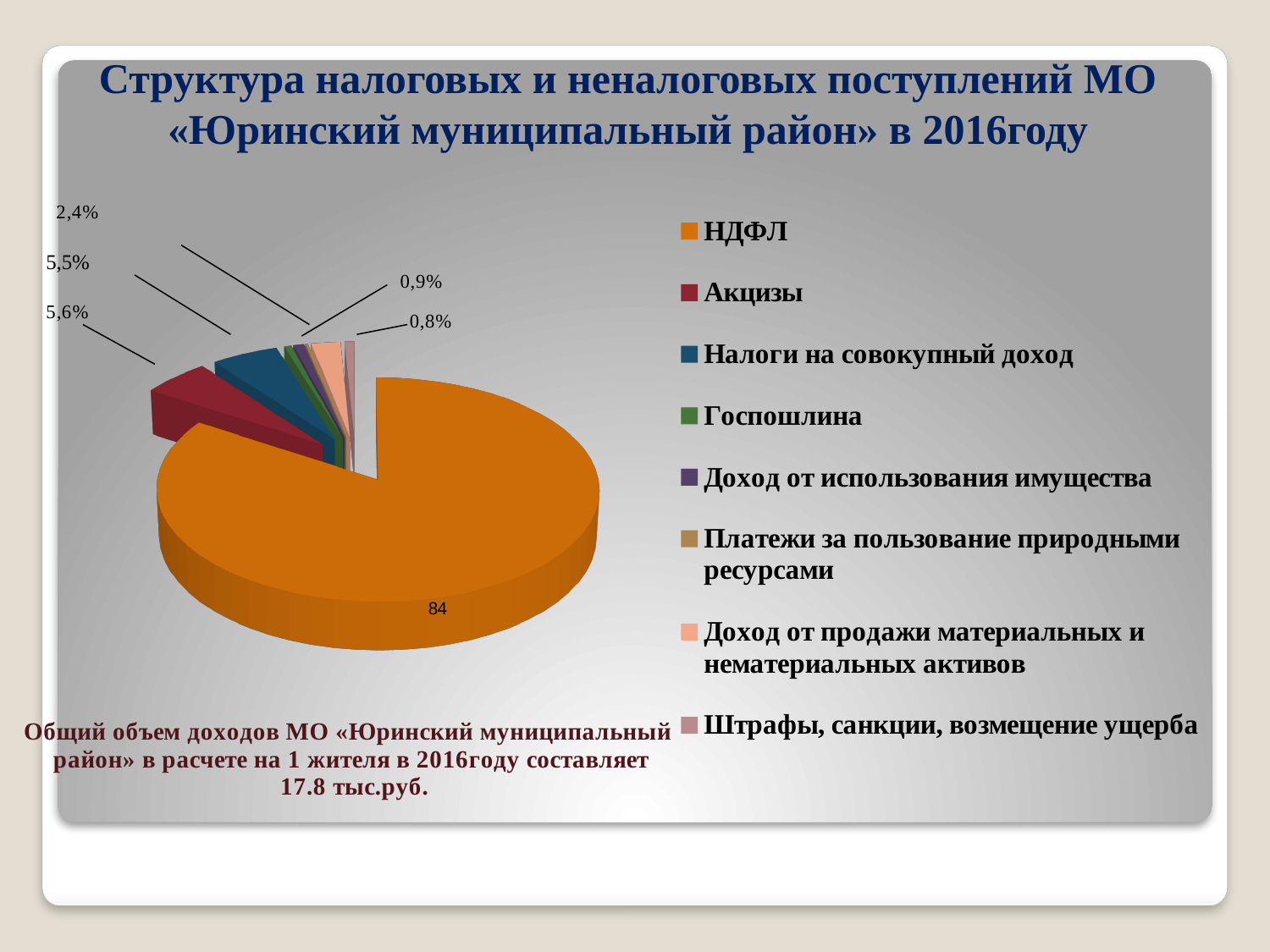
Which year does the chart title say the data refers to? 2016 Is the share of НДФЛ greater or less than 50%? greater Which category has the largest slice of the pie chart? НДФЛ What colour is the НДФЛ slice in the pie chart? orange What is the value shown for Акцизы? 5,6% Which is larger, the value for Акцизы or the value for Налоги на совокупный доход? Акцизы What is the value shown for Налоги на совокупный доход? 5,5% How many entries does the legend of the pie chart list? 8 What is the difference between the values for Акцизы and Налоги на совокупный доход? 0,1% What kind of chart is shown on the slide? pie chart What value is printed on the НДФЛ slice? 84 What is the smallest percentage label printed on the pie chart? 0,8%